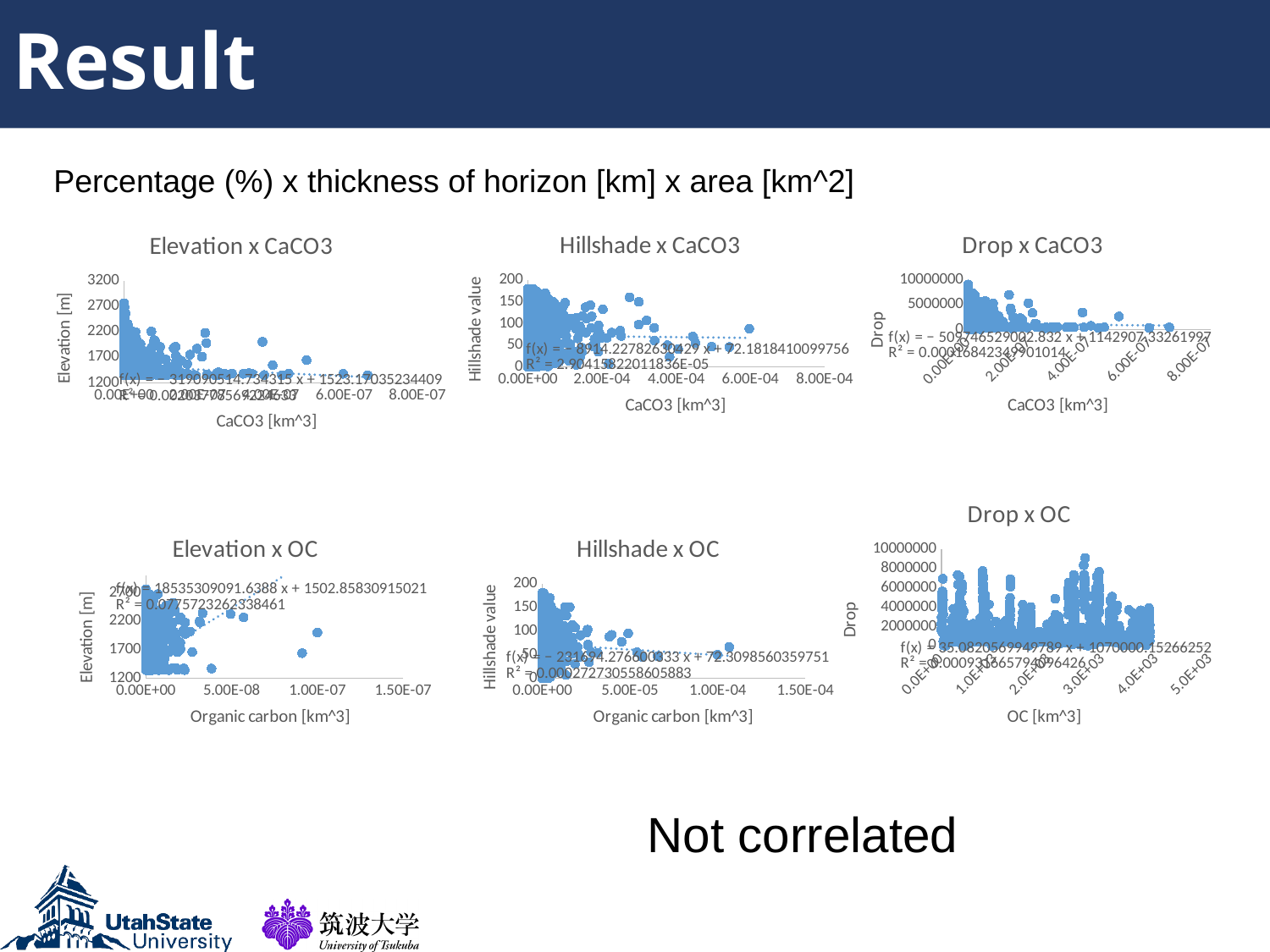
What is the y-axis title of the "Hillshade x CaCO3" chart? Hillshade value What R² value is printed on the "Elevation x OC" chart? 0.0775723262338461 How many charts are shown on the slide? 6 What is the highest tick value on the y axis of the "Drop x OC" chart? 10000000 What is the x-axis title of the "Elevation x OC" chart? Organic carbon [km^3] What kind of chart is the "Drop x OC" chart? Scatter chart What kind of chart is the "Elevation x CaCO3" chart? Scatter chart